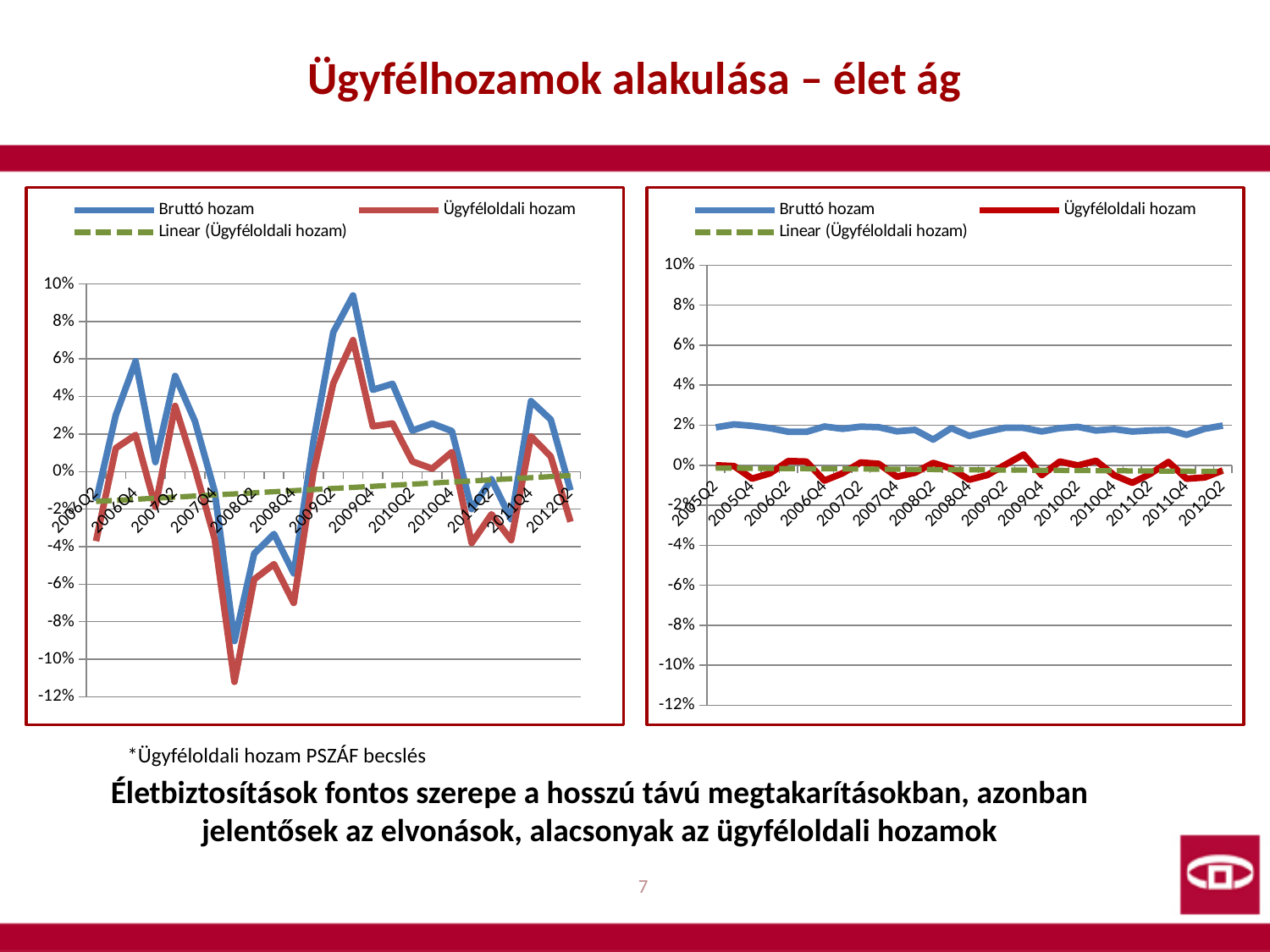
How many x-axis labels are shown on the right chart? 15 In the right chart, is the value of Bruttó hozam at 2012Q2 greater or less than 4%? less In the right chart, is the value of Ügyféloldali hozam at 2011Q2 greater or less than 2%? less In the right chart, which series is higher at 2008Q2, Bruttó hozam or Ügyféloldali hozam? Bruttó hozam What colour is the Bruttó hozam line in the left chart? blue In the left chart, is the lowest value of Bruttó hozam around 2008Q2 greater or less than -8%? less In the left chart, does the dashed Linear (Ügyféloldali hozam) trendline rise or fall from left to right? rise In the left chart, which series is higher at 2009Q2, Bruttó hozam or Ügyféloldali hozam? Bruttó hozam What kind of chart is the left chart on the slide? line chart How many series does the legend of the right chart list? 3